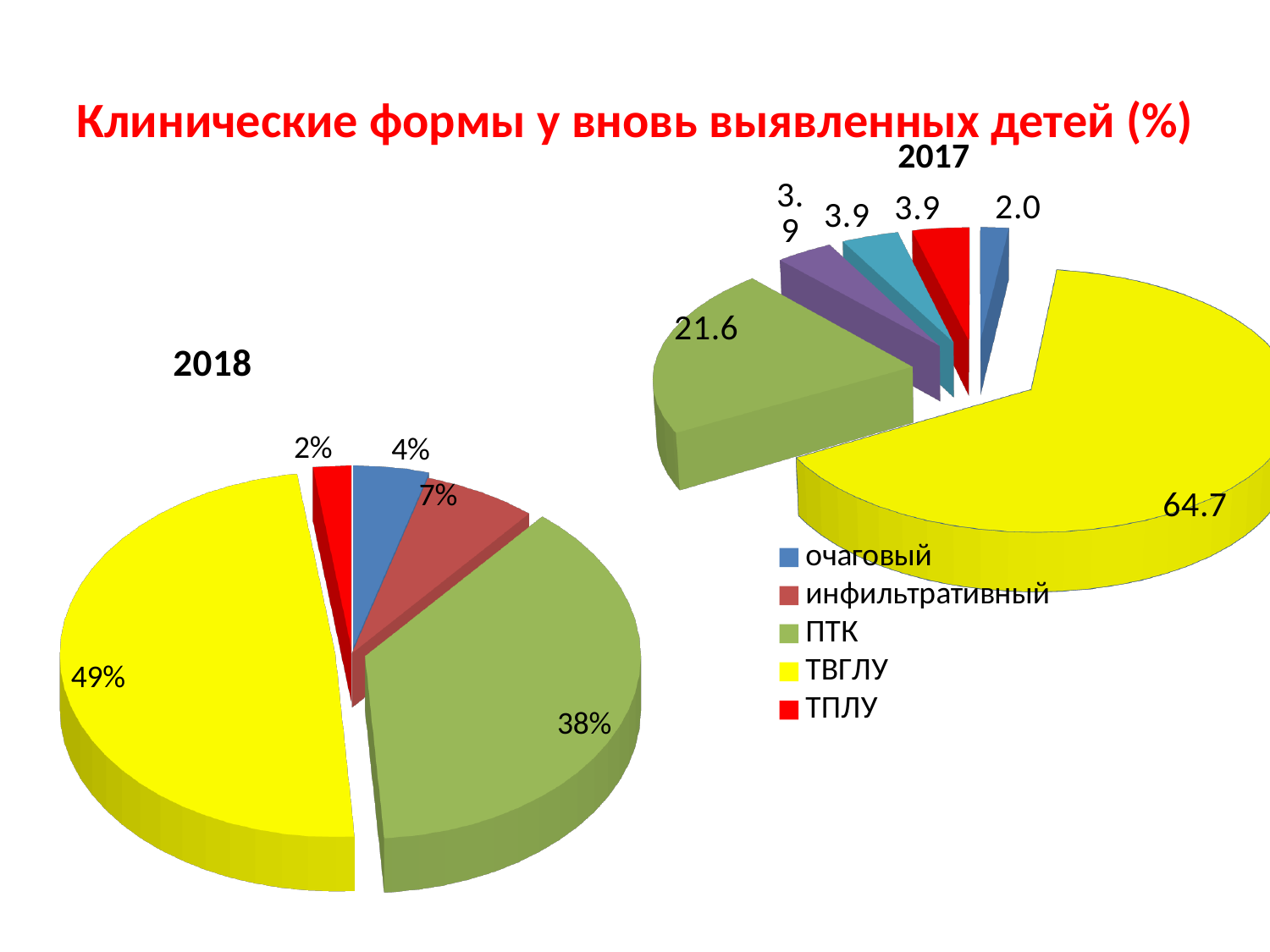
In the 2017 pie chart, what is the value for очаговый? 2.0 In the 2018 pie chart, which category has the smallest share? ТПЛУ In the 2018 pie chart, what is the share for ТВГЛУ? 49% In the 2018 pie chart, what is the share for ПТК? 38% In the 2018 pie chart, what is the share for инфильтративный? 7% What type of chart is used for the 2018 data? Pie chart In the 2017 pie chart, which is larger, the value for ПТК or the value for ТПЛУ? ПТК In the 2017 pie chart, what is the value for ПТК? 21.6 How many slices does the 2018 pie chart have? 5 In the 2018 pie chart, what is the difference between the shares of ТВГЛУ and ПТК? 11% In the 2018 pie chart, which category has the largest share? ТВГЛУ In the 2017 pie chart, what is the value for ТВГЛУ? 64.7